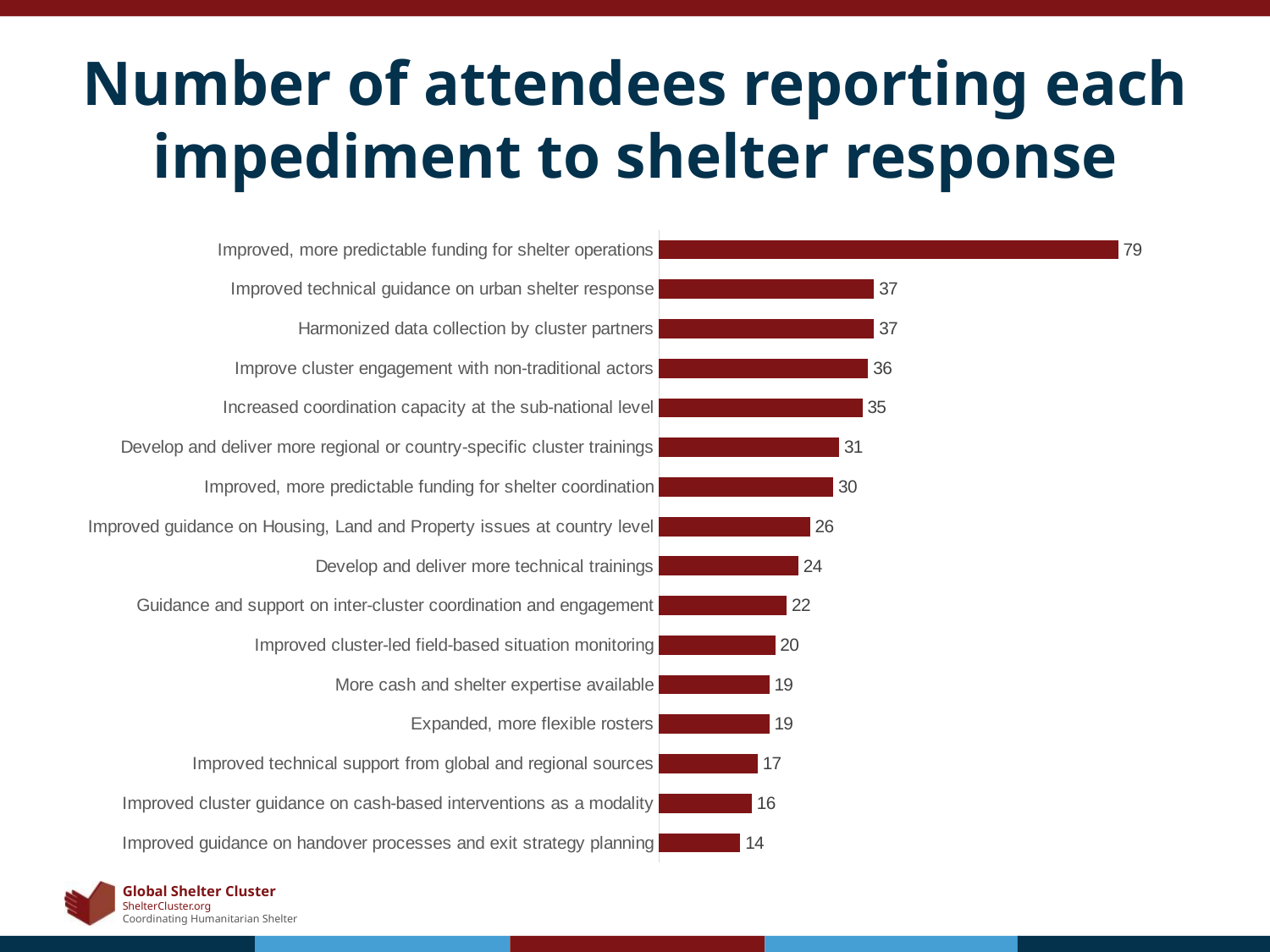
How many impediments are listed in the chart? 16 What kind of chart is shown on the slide? Bar chart Which impediment was reported by the fewest attendees? Improved guidance on handover processes and exit strategy planning What is the title of the slide? Number of attendees reporting each impediment to shelter response What is the value for 'Develop and deliver more technical trainings'? 24 How many attendees reported 'Improved, more predictable funding for shelter operations' as an impediment? 79 Which impediment was reported by the most attendees? Improved, more predictable funding for shelter operations What is the difference between the values for 'Improved, more predictable funding for shelter operations' and 'Improved technical guidance on urban shelter response'? 42 Which has a higher value: 'Develop and deliver more regional or country-specific cluster trainings' or 'Guidance and support on inter-cluster coordination and engagement'? Develop and deliver more regional or country-specific cluster trainings What is the difference between the values for 'Increased coordination capacity at the sub-national level' and 'Improved cluster-led field-based situation monitoring'? 15 Which has a lower value: 'Improved technical support from global and regional sources' or 'Improved cluster guidance on cash-based interventions as a modality'? Improved cluster guidance on cash-based interventions as a modality What is the value for 'Improved guidance on handover processes and exit strategy planning'? 14